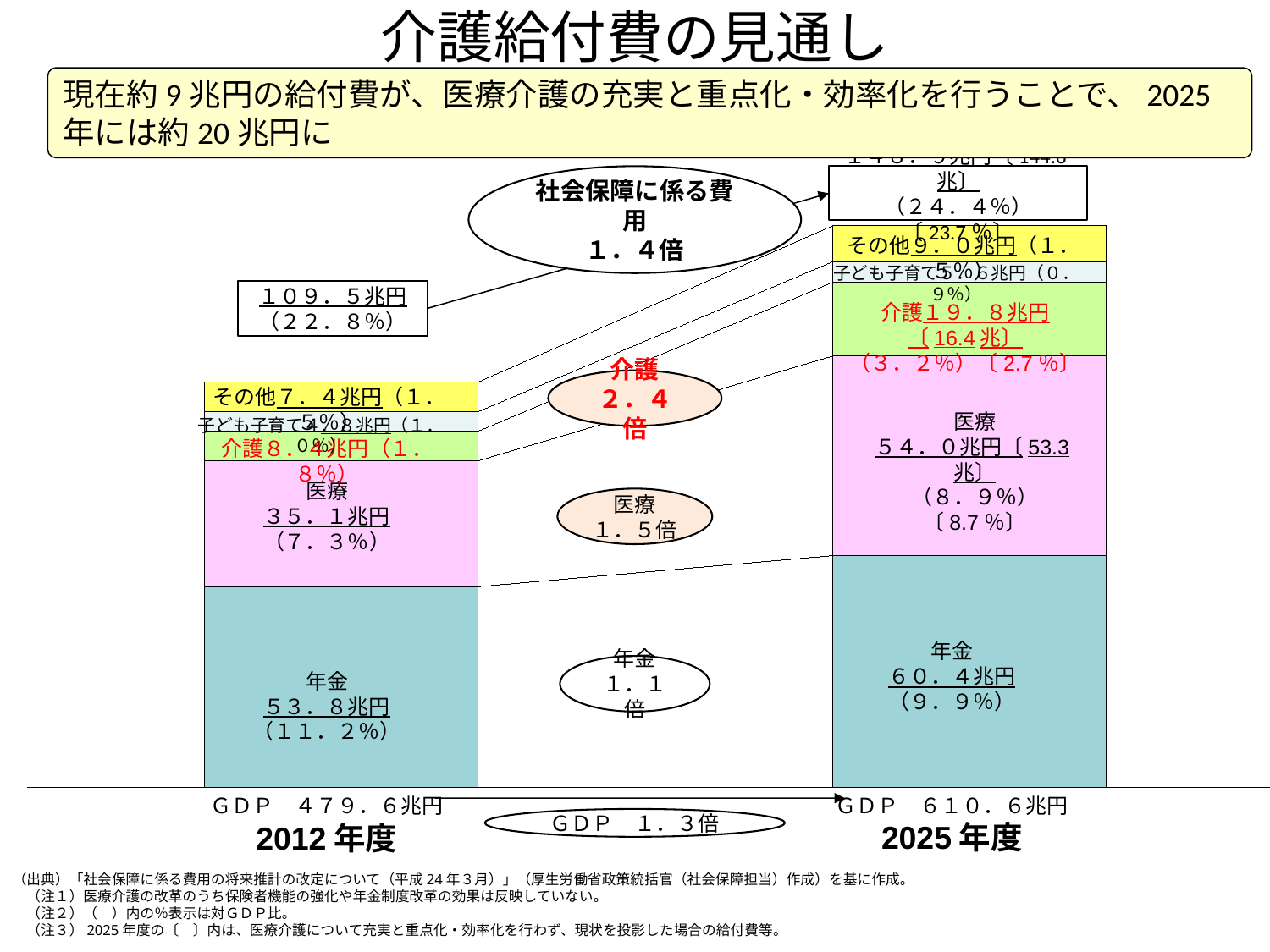
What kind of chart is shown on the slide? stacked bar chart What is the GDP shown for 2025年度? 610.6兆円 By how much does 年金 increase from 2012年度 to 2025年度? 6.6兆円 Which segment is the largest in the 2012年度 bar? 年金 What is the value of 介護 in 2012年度? 8.4兆円 Which is larger in 2025年度, 医療 or 年金? 年金 What is the value of 医療 in 2025年度? 54.0兆円 By how much does 介護 increase from 2012年度 to 2025年度? 11.4兆円 What is the value of 年金 in 2012年度? 53.8兆円 What is the value of 介護 in 2025年度? 19.8兆円 What is the value of 年金 in 2025年度? 60.4兆円 How many fiscal years (bars) are compared in the chart? 2